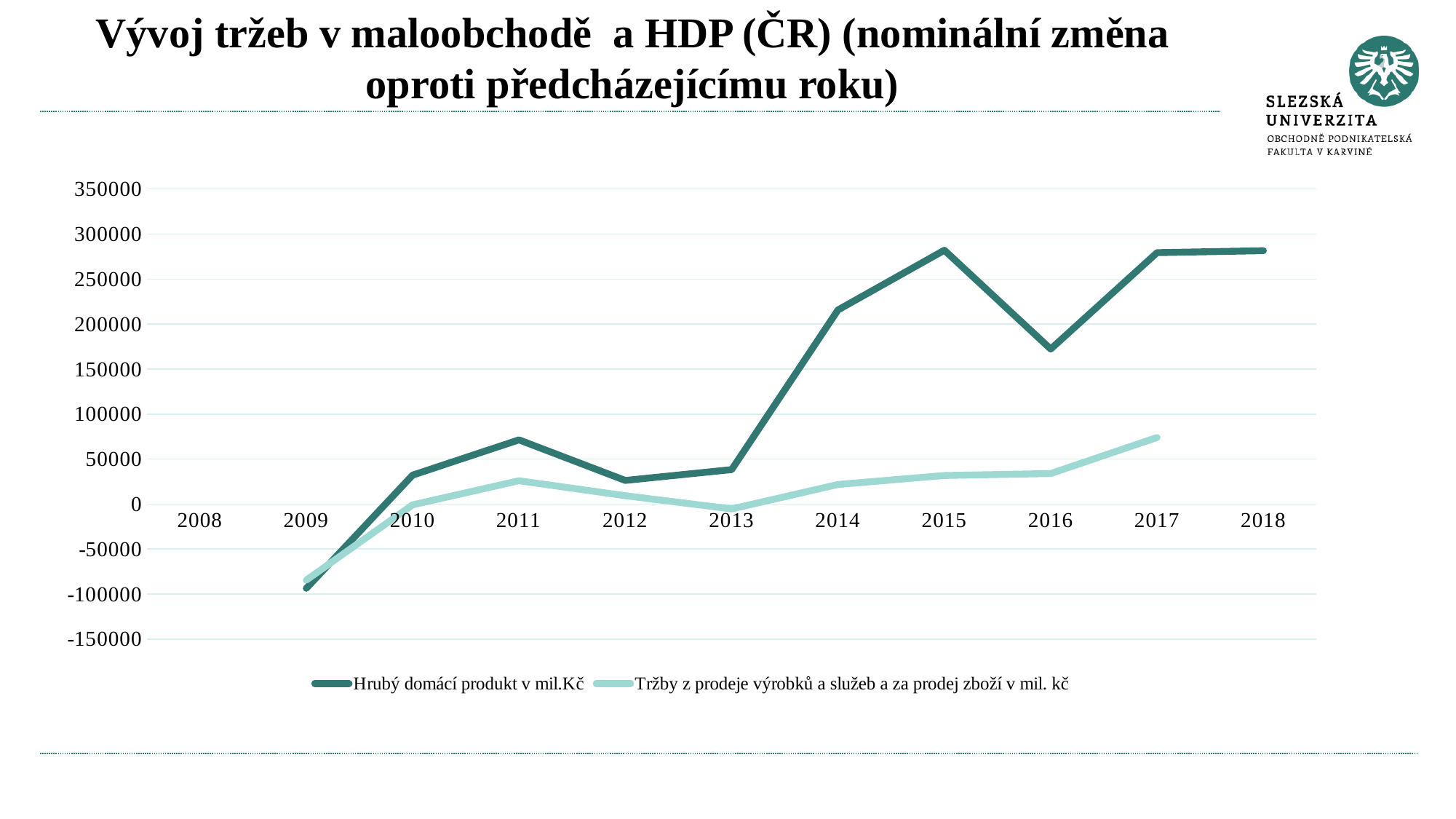
Is the value for Hrubý domácí produkt v mil.Kč in 2014 greater or less than 200000? greater How many years are shown on the x axis? 11 Is the value for Tržby z prodeje výrobků a služeb a za prodej zboží v mil. kč in 2017 greater or less than 50000? greater Is the value for Hrubý domácí produkt v mil.Kč in 2009 greater or less than -50000? less In which year is the value for Tržby z prodeje výrobků a služeb a za prodej zboží v mil. kč highest? 2017 What is the first entry listed in the chart legend? Hrubý domácí produkt v mil.Kč In 2014, which series has the larger value: Hrubý domácí produkt v mil.Kč or Tržby z prodeje výrobků a služeb a za prodej zboží v mil. kč? Hrubý domácí produkt v mil.Kč How many series does the legend list? 2 In which year is the value for Hrubý domácí produkt v mil.Kč lowest? 2009 What kind of chart is shown on the slide? line chart Does the value for Tržby z prodeje výrobků a služeb a za prodej zboží v mil. kč rise or fall from 2013 to 2017? rise